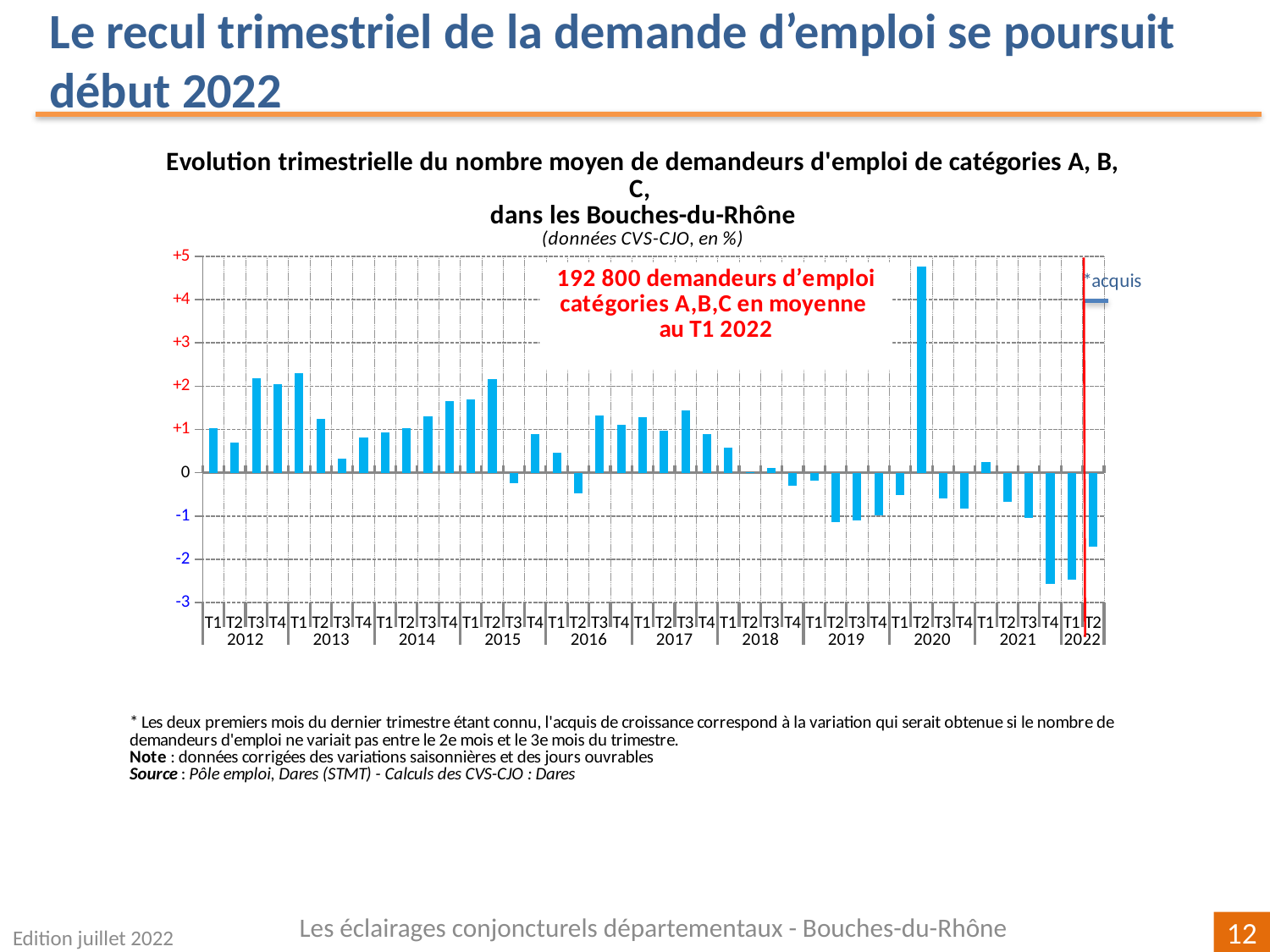
Which is larger, the value for T3 2012 or the value for T1 2012? T3 2012 Do the values rise or fall across the four quarters of 2021 (T1 to T4)? fall Is the value for T2 2020 greater or less than +4? greater How many years are labelled on the x axis of the chart? 11 Is the value for T3 2015 greater or less than 0? less Is the value for T4 2021 greater or less than -2? less What kind of chart is shown on the slide? bar chart Which is larger, the value for T2 2020 or the value for T1 2013? T2 2020 According to the annotation on the chart, how many job seekers in categories A, B, C were there on average in T1 2022? 192 800 Which quarter has the highest value on the chart? T2 2020